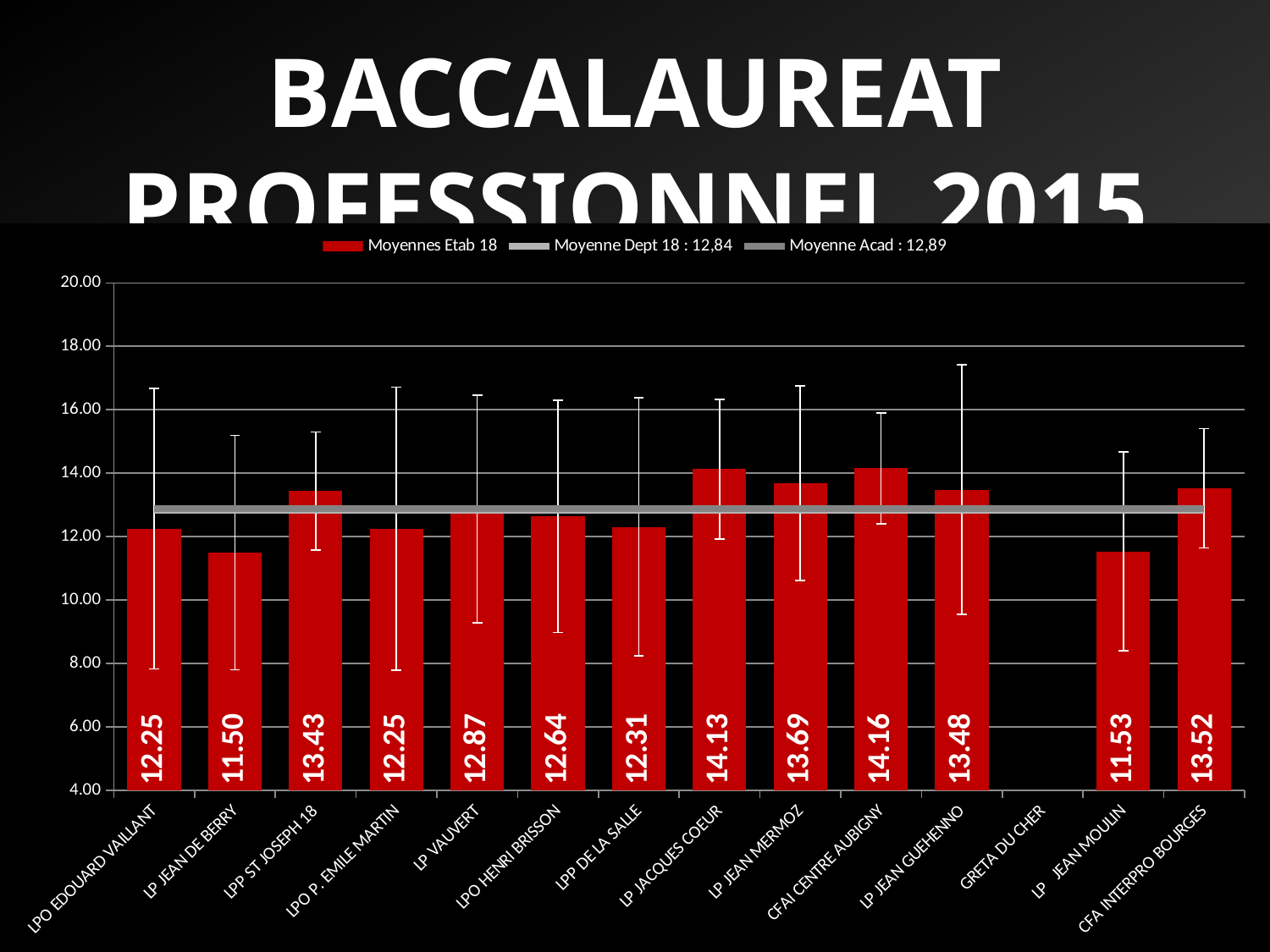
What is the value for LP VAUVERT? 12.87 Is the value for LP JEAN MOULIN greater or less than 12.00? less What is the value for CFA INTERPRO BOURGES? 13.52 What is the difference between the values for LP JEAN MERMOZ and LPP DE LA SALLE? 1.38 What is the value for LP JACQUES COEUR? 14.13 How many establishments are labelled on the x axis? 14 How many entries does the legend list? 3 What kind of chart is shown? bar chart Which is larger, the value for LPP ST JOSEPH 18 or the value for LPO HENRI BRISSON? LPP ST JOSEPH 18 Which establishment has the highest value? CFAI CENTRE AUBIGNY What is the value for LP JEAN DE BERRY? 11.50 What value does the legend give for Moyenne Dept 18? 12,84